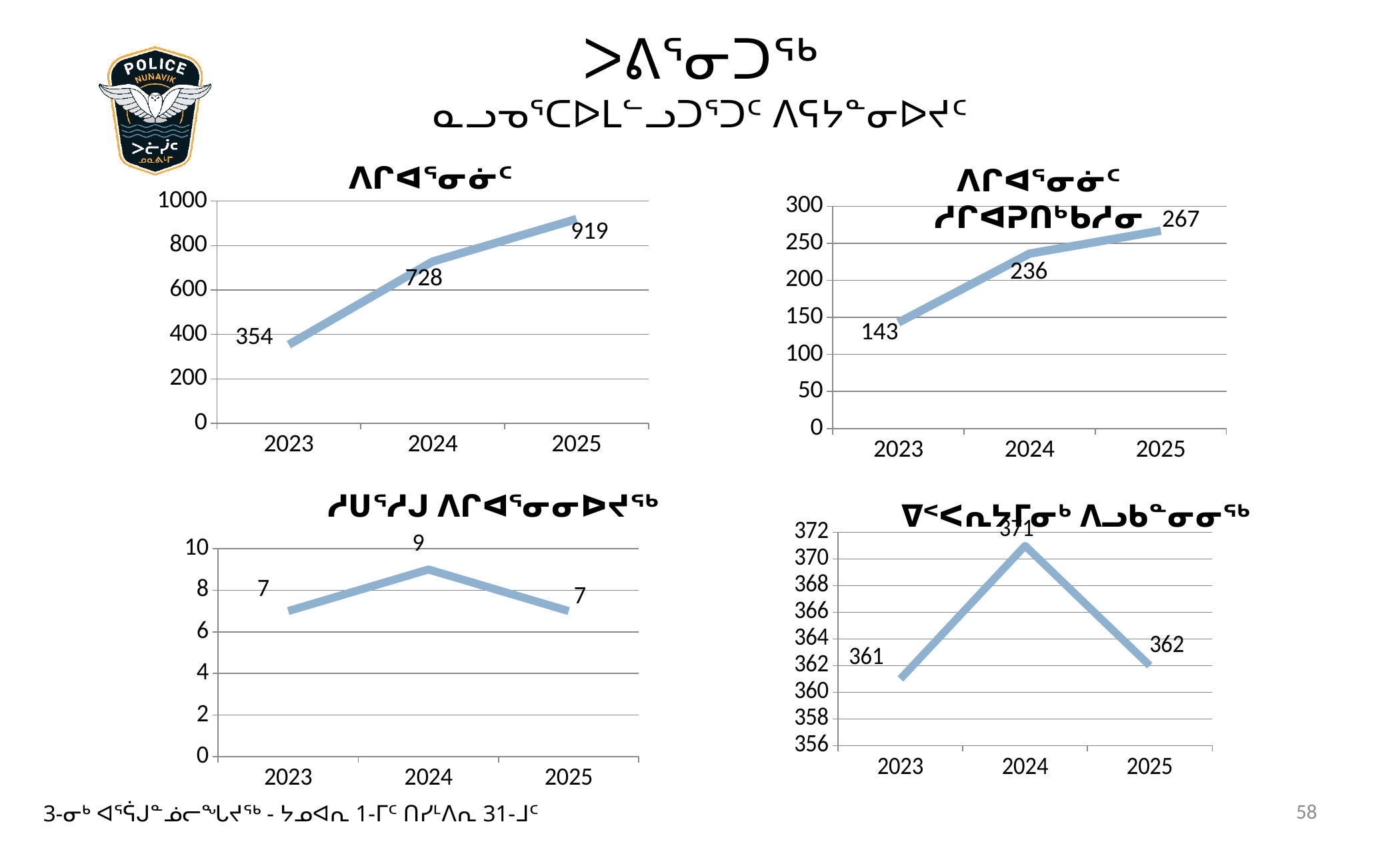
What type of chart is the top-left chart? line chart In the top-left chart, what is the difference between the 2025 and 2023 values? 565 In the top-left chart, what is the value for 2024? 728 In the bottom-left chart, what is the value for 2024? 9 In the bottom-right chart, what is the difference between the 2024 and 2025 values? 9 In the top-right chart, what is the value for 2023? 143 In the top-left chart, what is the value for 2025? 919 In the bottom-left chart, how many data points are plotted? 3 In the bottom-right chart, which year has the lowest value? 2023 In the bottom-right chart, which is larger, the value for 2023 or the value for 2025? 2025 In the top-right chart, do the values rise or fall from 2023 to 2025? rise In the top-right chart, which year has the highest value? 2025